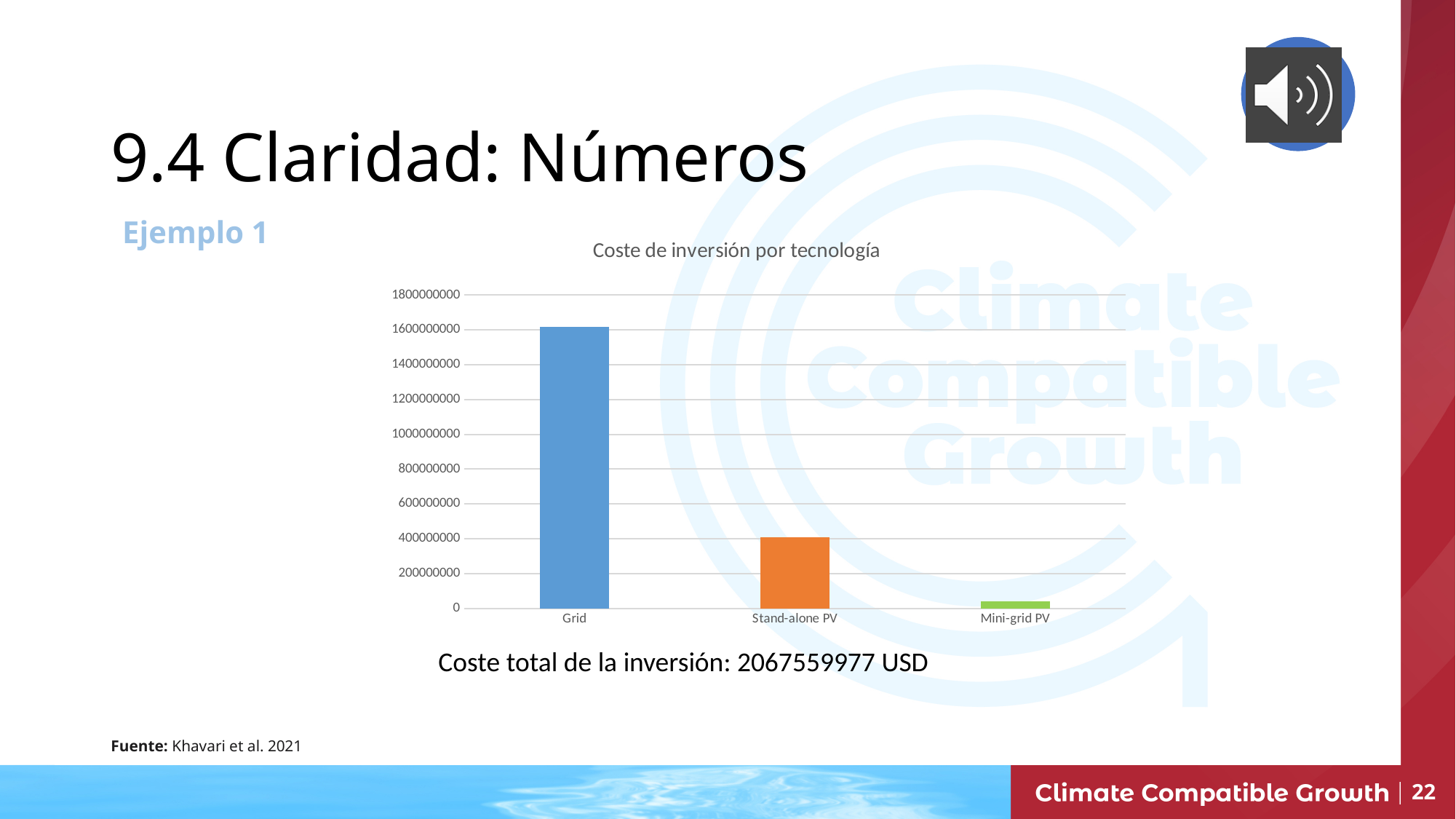
Is the value for Stand-alone PV greater or less than 600000000? less Which is larger, the value for Stand-alone PV or the value for Mini-grid PV? Stand-alone PV What is the highest tick value shown on the y axis? 1800000000 Which category has the highest investment cost? Grid Is the value for Grid greater or less than 1400000000? greater Is the value for Mini-grid PV greater or less than 200000000? less How many categories are shown on the x axis of the chart? 3 What kind of chart is shown on the slide? bar chart Which category has the lowest investment cost? Mini-grid PV What is the title of the chart? Coste de inversión por tecnología Which is larger, the value for Grid or the value for Stand-alone PV? Grid Do the values rise or fall from left to right along the x axis? fall